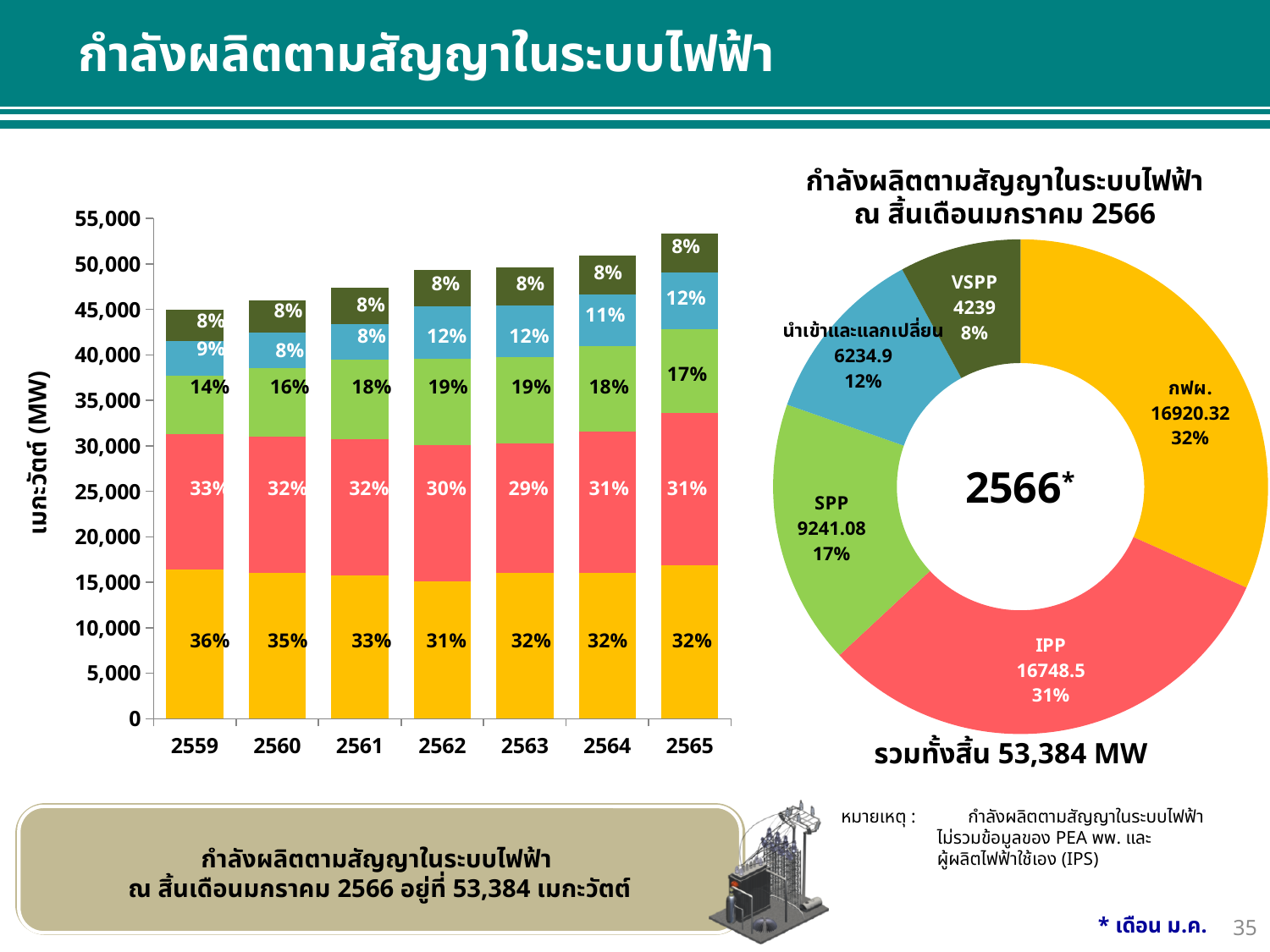
In the bar chart on the left, do the total bar heights rise or fall from 2559 to 2565? rise What total is printed below the doughnut chart on the right? 53,384 MW How many years are shown on the x axis of the bar chart on the left? 7 In the doughnut chart on the right, what is the difference between the values for กฟผ. and IPP? 171.82 How many segments does the doughnut chart on the right have? 5 What kind of chart is the chart on the left of the slide? Stacked bar chart In the doughnut chart on the right, what share does SPP have? 17% In the doughnut chart on the right, what is the value shown for IPP? 16748.5 In the bar chart on the left, is the total height of the 2565 bar greater or less than 50,000? greater In the doughnut chart on the right, which segment is the smallest? VSPP In the bar chart on the left, what percentage is printed on the bottom (yellow) segment of the 2559 bar? 36% In the doughnut chart on the right, which segment is the largest? กฟผ.